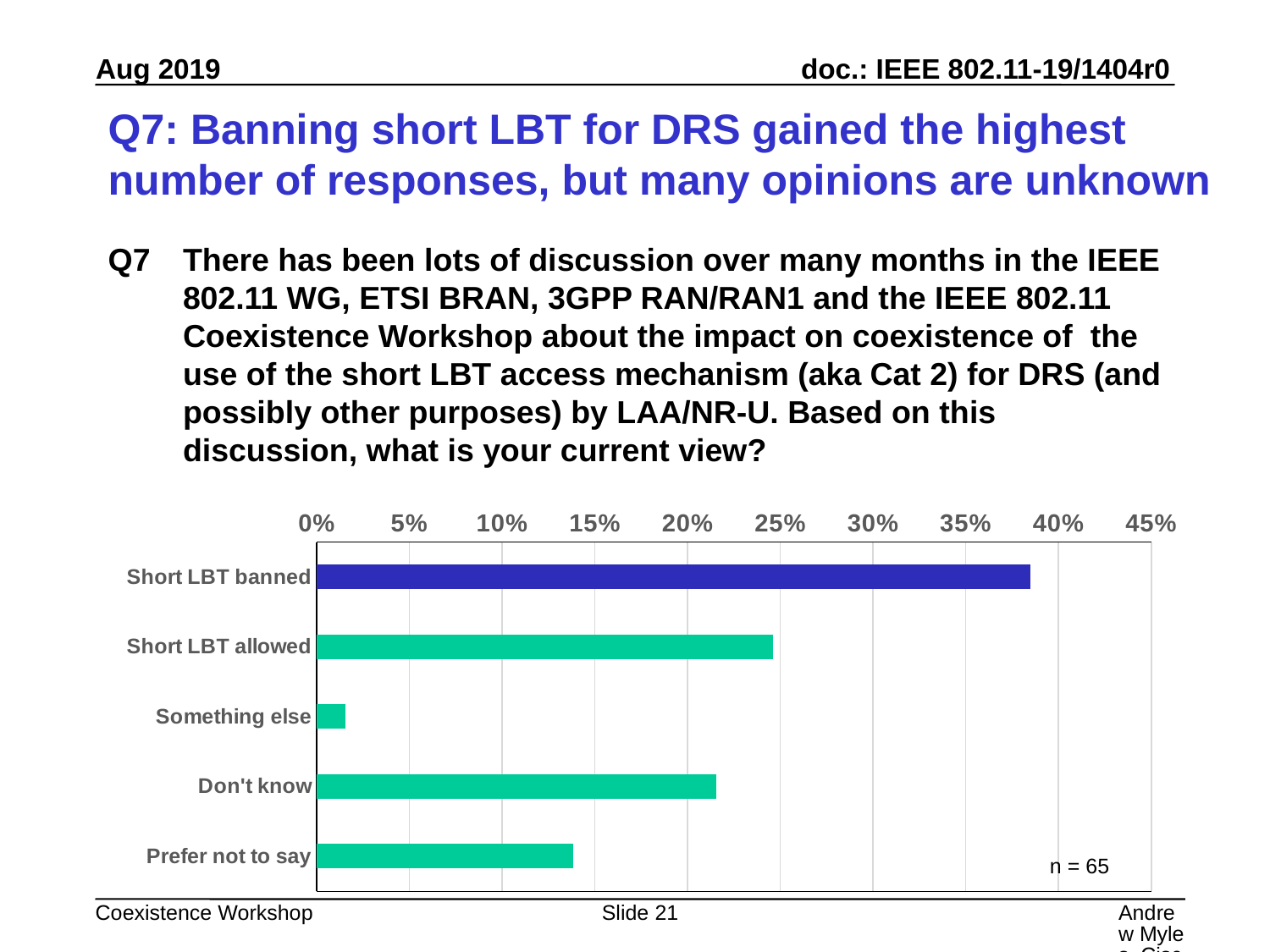
What kind of chart is shown on the slide? bar chart Is the value for Prefer not to say greater or less than 10%? greater Which category has the lowest value in the chart? Something else Is the value for Short LBT banned greater or less than 35%? greater Is the value for Something else greater or less than 5%? less What sample size (n) is noted on the chart? n = 65 Which is larger, the value for Prefer not to say or the value for Short LBT banned? Short LBT banned How many categories are plotted in the chart? 5 Which is larger, the value for Short LBT allowed or the value for Don't know? Short LBT allowed Which category has the highest value in the chart? Short LBT banned